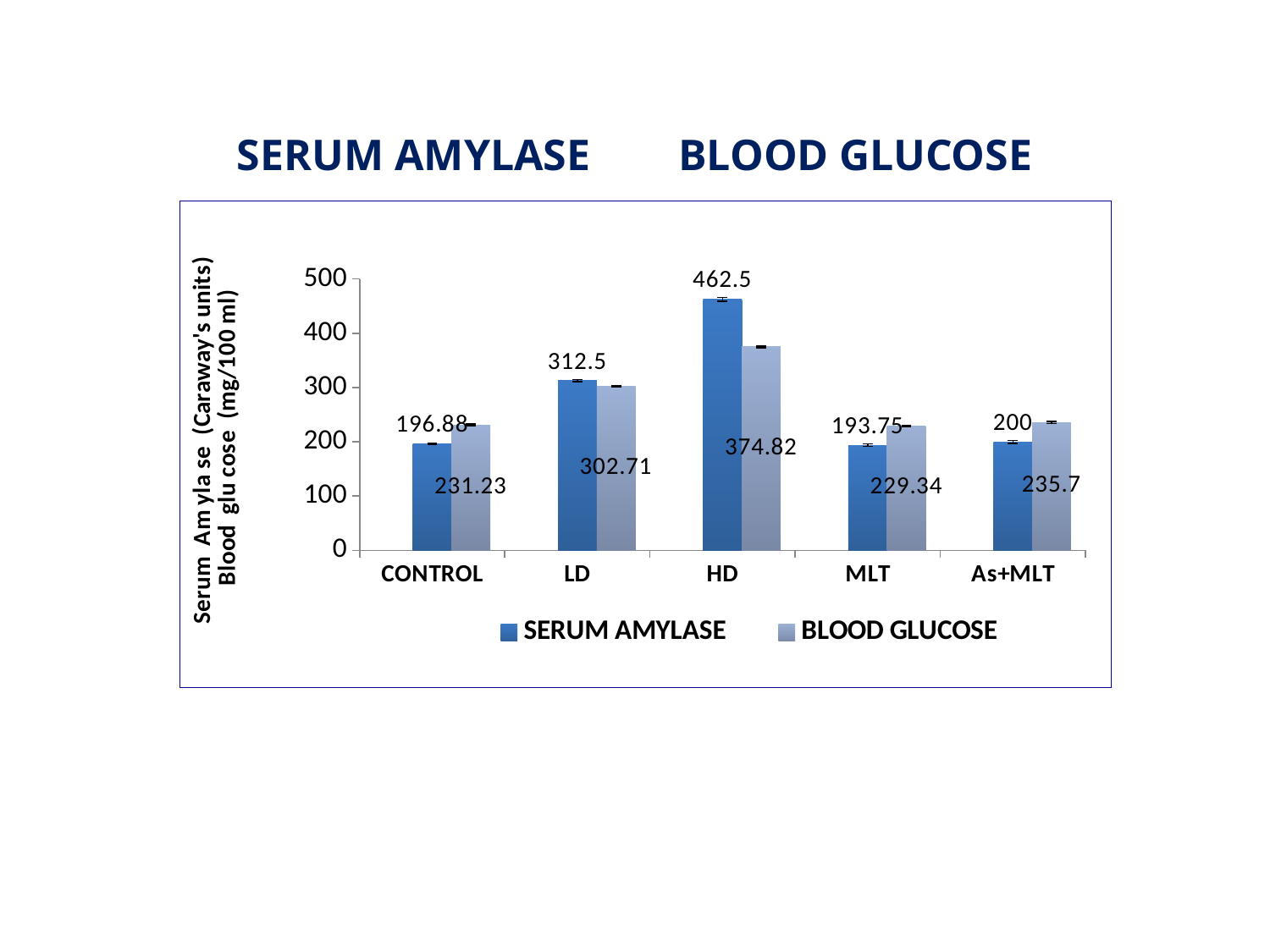
What is the BLOOD GLUCOSE value for the As+MLT group? 235.7 What kind of chart is shown on the slide? bar chart Which group has the highest SERUM AMYLASE value? HD What is the SERUM AMYLASE value for the HD group? 462.5 What is the BLOOD GLUCOSE value for the LD group? 302.71 Which group has the lowest BLOOD GLUCOSE value? MLT What is the difference between the SERUM AMYLASE values for HD and LD? 150 Which is larger for the MLT group, SERUM AMYLASE or BLOOD GLUCOSE? BLOOD GLUCOSE How many series does the legend list? 2 What is the SERUM AMYLASE value for the CONTROL group? 196.88 How many groups are shown on the x axis? 5 Is the BLOOD GLUCOSE value for HD greater or less than 300? greater